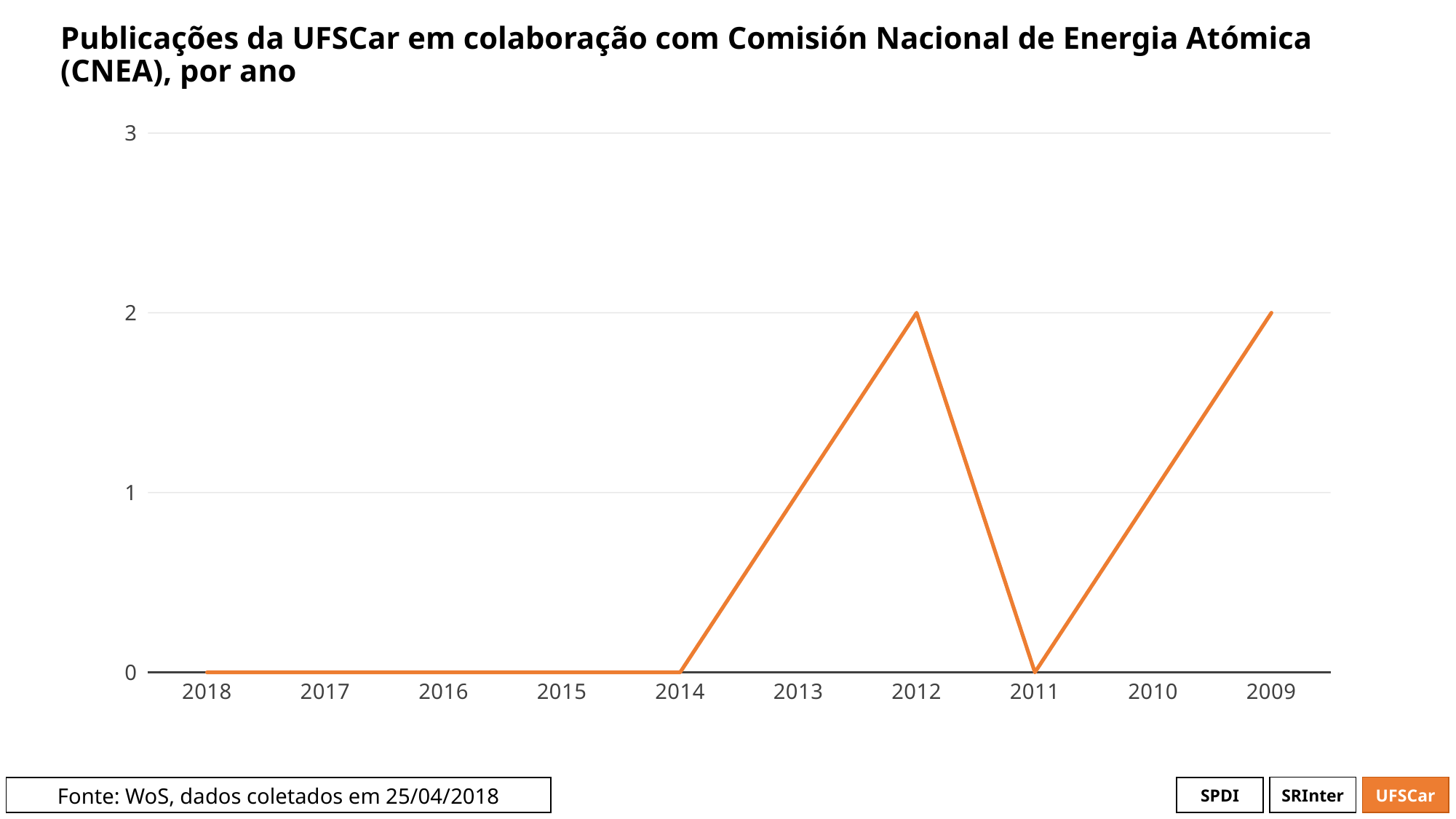
What is the value for 2010? 1 How many years are shown on the x axis? 10 What is the data source stated on the slide? WoS, dados coletados em 25/04/2018 What is the value for 2012? 2 What is the value for 2009? 2 What is the value for 2013? 1 What is the value for 2011? 0 Is the value for 2009 greater or less than 1? greater What kind of chart is shown on the slide? line chart Which is larger, the value for 2012 or the value for 2011? 2012 What is the value for 2016? 0 What is the difference between the value for 2012 and the value for 2011? 2